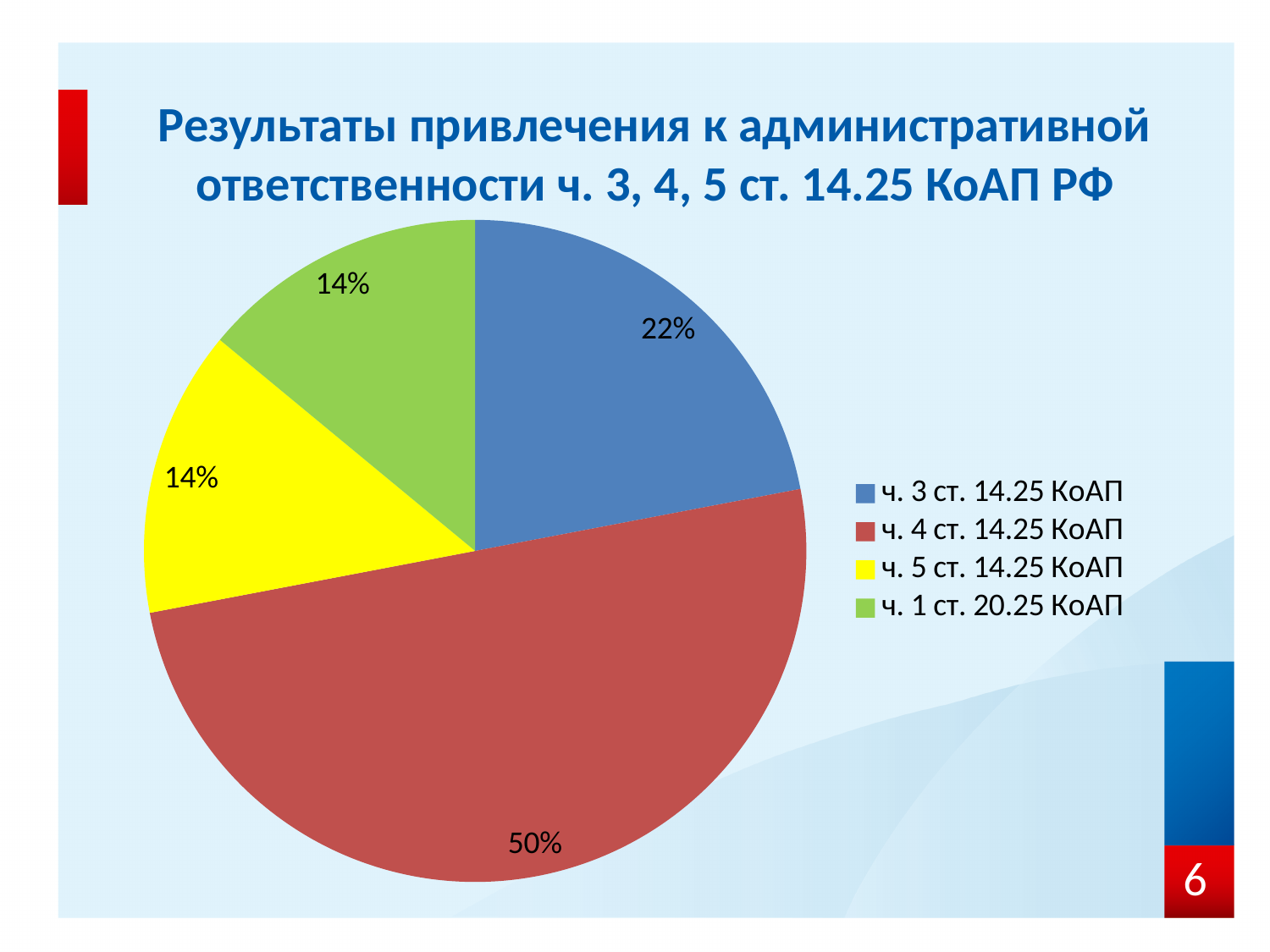
How many slices does the pie chart have? 4 What is the difference in percentage points between ч. 4 ст. 14.25 КоАП and ч. 3 ст. 14.25 КоАП? 28 What share of the pie does ч. 3 ст. 14.25 КоАП have? 22% What share of the pie does ч. 1 ст. 20.25 КоАП have? 14% What share of the pie does ч. 4 ст. 14.25 КоАП have? 50% Which is larger, the slice for ч. 3 ст. 14.25 КоАП or the slice for ч. 5 ст. 14.25 КоАП? ч. 3 ст. 14.25 КоАП How many entries does the legend list? 4 What kind of chart is shown on the slide? pie chart What colour is the slice for ч. 1 ст. 20.25 КоАП? green Which category has the largest slice of the pie? ч. 4 ст. 14.25 КоАП What is the title of the chart on the slide? Результаты привлечения к административной ответственности ч. 3, 4, 5 ст. 14.25 КоАП РФ